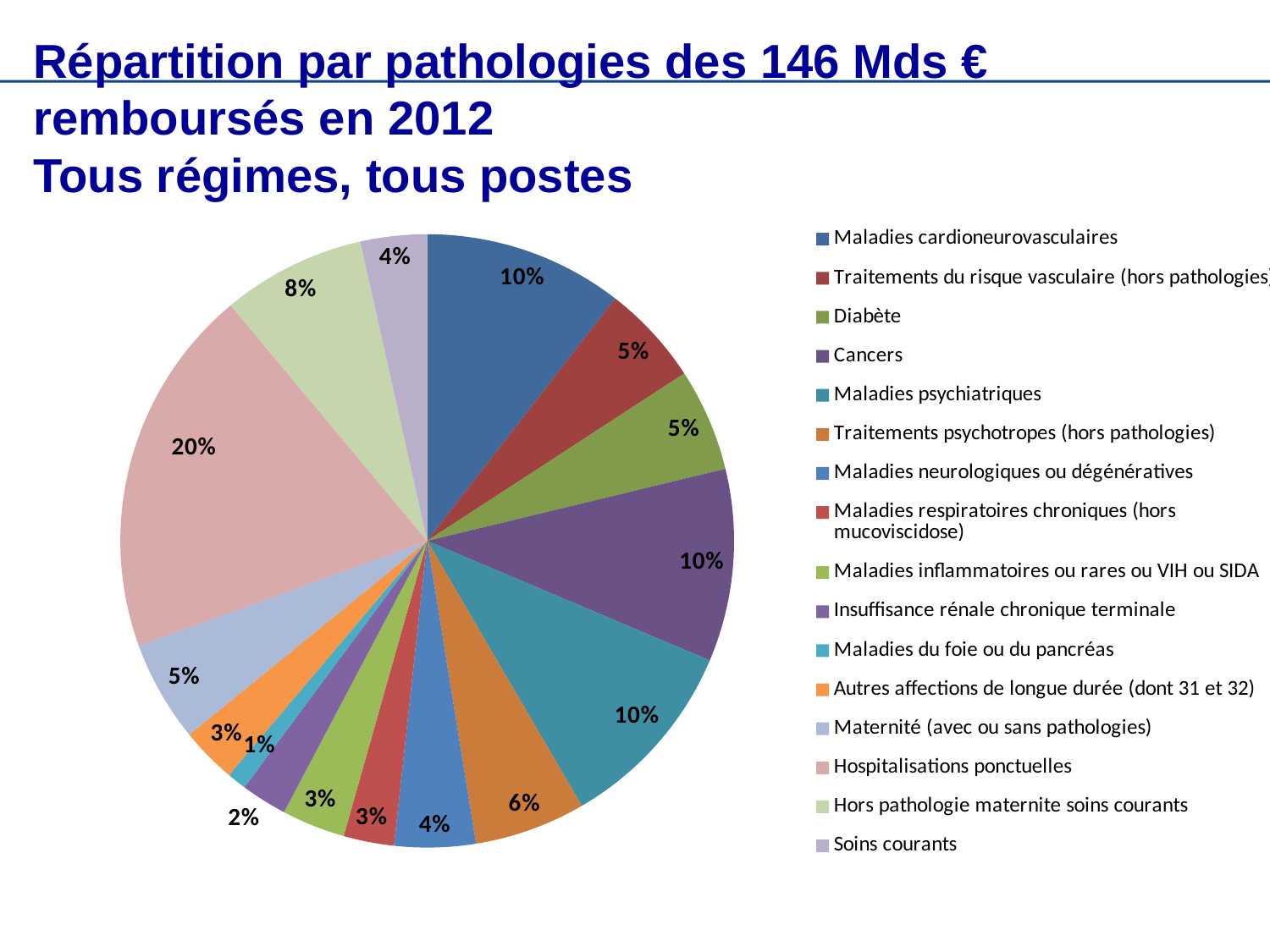
What percentage is shown for Insuffisance rénale chronique terminale? 2% How many categories does the legend list? 16 Which is larger, the share for Maternité (avec ou sans pathologies) or the share for Soins courants? Maternité (avec ou sans pathologies) Which category has the smallest slice of the pie? Maladies du foie ou du pancréas What share of the pie is labelled for Hospitalisations ponctuelles? 20% What kind of chart is shown on the slide? pie chart What percentage is shown for Maladies cardioneurovasculaires? 10% What is the difference in percentage points between Hospitalisations ponctuelles and Cancers? 10 Which category has the largest slice of the pie? Hospitalisations ponctuelles What is the title of the slide? Répartition par pathologies des 146 Mds € remboursés en 2012 Tous régimes, tous postes What percentage is shown for Hors pathologie maternite soins courants? 8% What percentage is shown for Traitements psychotropes (hors pathologies)? 6%